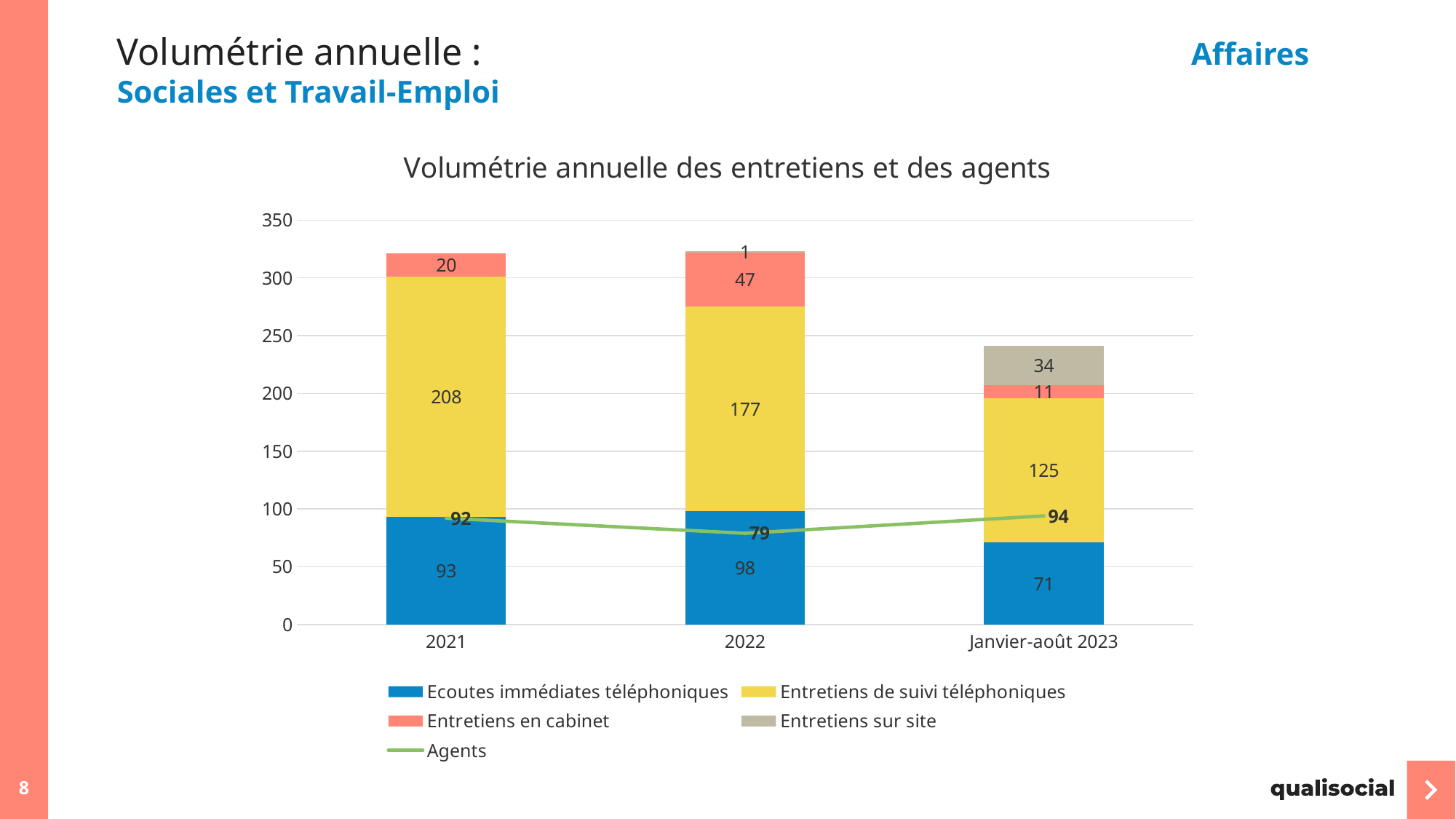
What is the value for Entretiens de suivi téléphoniques in 2022? 177 What is the value of the Agents line for Janvier-août 2023? 94 Which is larger: Ecoutes immédiates téléphoniques in 2021 or in 2022? 2022 What is the value for Entretiens sur site in Janvier-août 2023? 34 What is the value for Ecoutes immédiates téléphoniques in 2021? 93 How many series does the legend list? 5 What is the difference between Entretiens en cabinet in 2022 and in 2021? 27 Which period has the lowest value on the Agents line? 2022 What is the total of the stacked bar for Janvier-août 2023? 241 Which period has the highest value for Entretiens de suivi téléphoniques? 2021 How many periods are shown on the x axis? 3 Do the values for Entretiens de suivi téléphoniques rise or fall from 2021 to Janvier-août 2023? fall